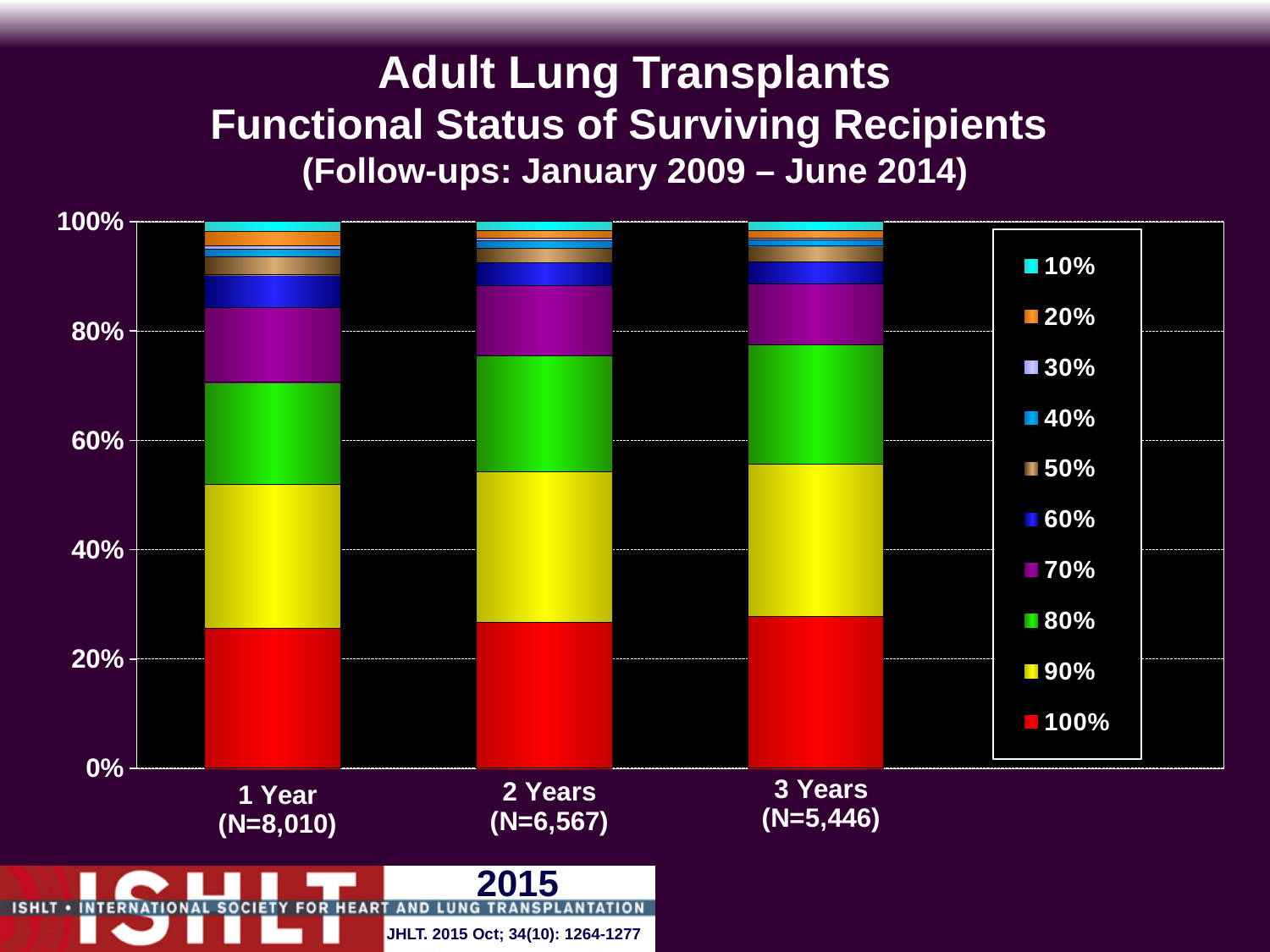
Is the 100% functional status segment for 3 Years greater or less than 40%? less Which bar has the larger 70% functional status segment, 1 Year or 3 Years? 1 Year Is the 100% functional status segment for 1 Year greater or less than 20%? greater How many series does the legend list? 10 How many follow-up time categories are plotted on the x axis? 3 Which bar has the larger 80% functional status segment, 1 Year or 3 Years? 3 Years What is the title of the chart? Adult Lung Transplants Functional Status of Surviving Recipients (Follow-ups: January 2009 – June 2014) Does the top of the 80% segment in the 1 Year bar sit above or below the 60% gridline? above What is the total height of each stacked bar? 100% What kind of chart is shown on the slide? Stacked bar chart What is the N shown for the 2 Years category? N=6,567